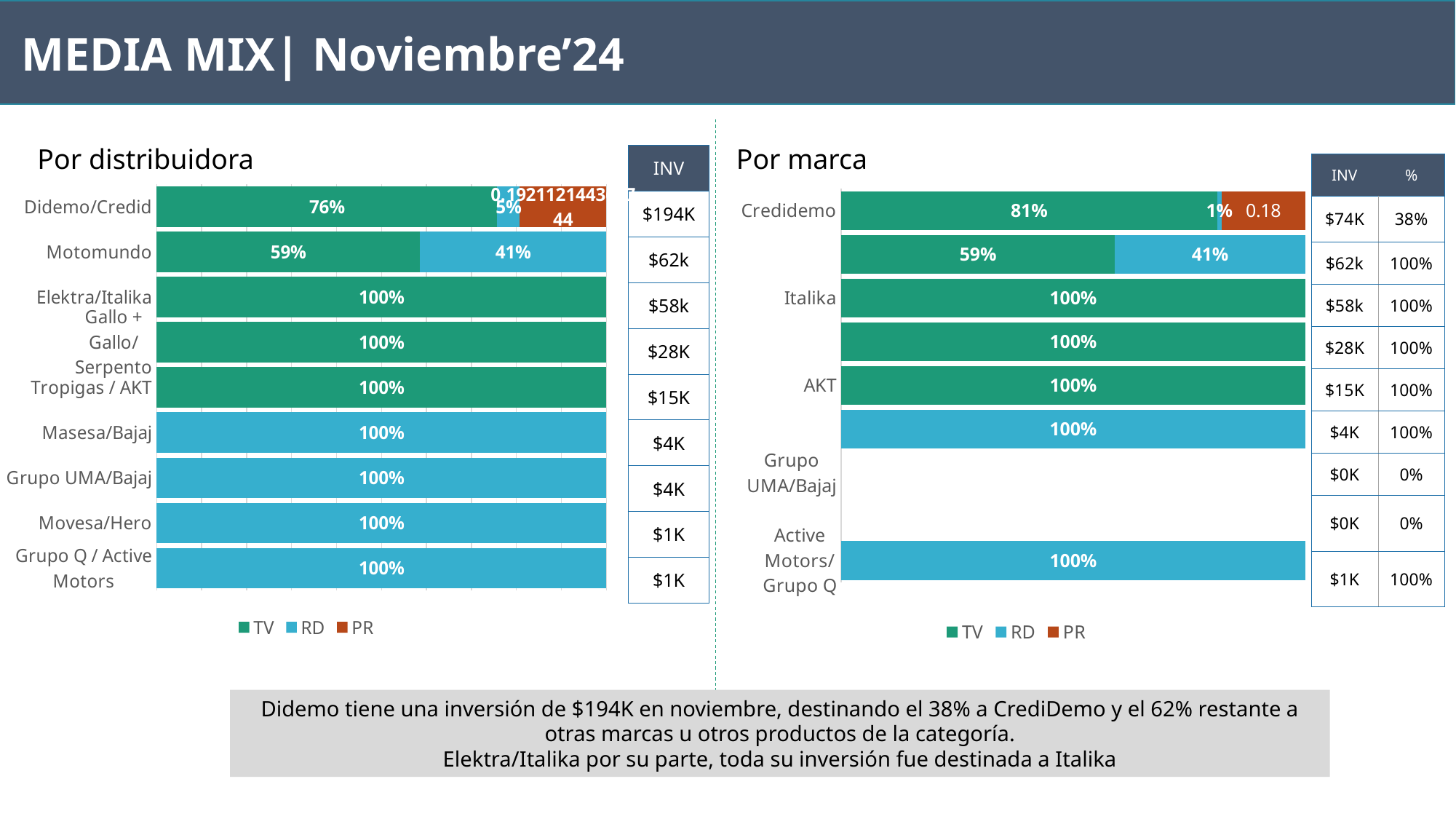
In the 'Por marca' chart, what percentage of Italika's media mix is TV? 100% In the 'Por distribuidora' chart, what percentage of Motomundo's media mix is RD? 41% In the 'Por distribuidora' chart, what percentage of Motomundo's media mix is TV? 59% In the 'Por distribuidora' chart, which is larger for Motomundo, the TV share or the RD share? TV What type of chart is the 'Por marca' chart? Stacked bar chart In the 'Por distribuidora' chart, what percentage of Didemo/Credid's media mix is TV? 76% What are the legend entries of the 'Por marca' chart? TV, RD, PR In the 'Por distribuidora' chart, what percentage of Masesa/Bajaj's media mix is RD? 100% In the 'Por marca' chart, what percentage of Credidemo's media mix is RD? 1% How many series does the legend of the 'Por distribuidora' chart list? 3 In the 'Por distribuidora' chart, what is the difference between Motomundo's TV share and RD share? 18 percentage points In the 'Por marca' chart, what percentage of Credidemo's media mix is TV? 81%